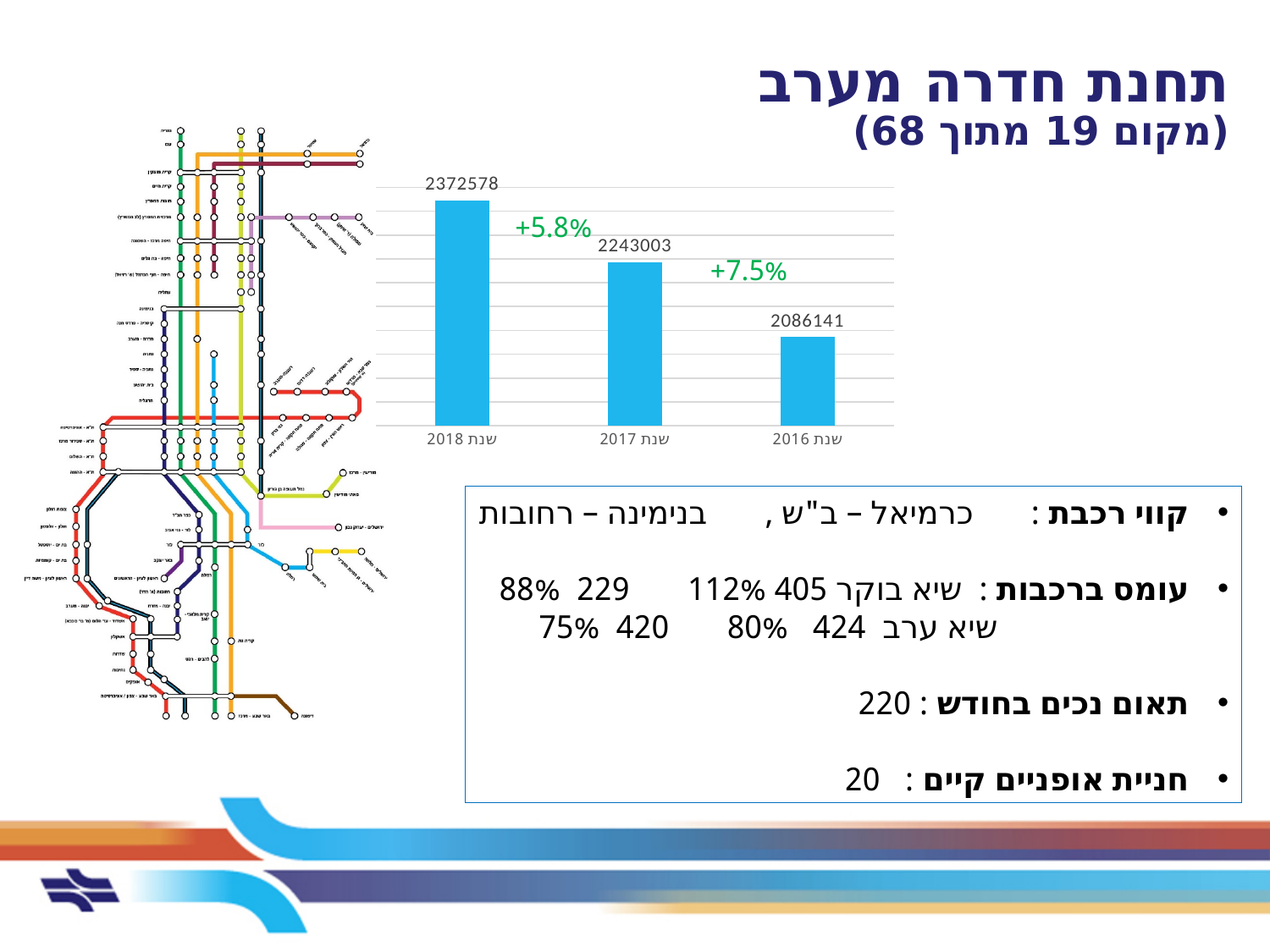
What percentage change is annotated between שנת 2016 and שנת 2017? +7.5% Which is larger, the value for שנת 2017 or the value for שנת 2016? שנת 2017 What value is shown for שנת 2016? 2086141 Which year has the lowest value? שנת 2016 What percentage change is annotated between שנת 2017 and שנת 2018? +5.8% How many bars are in the chart? 3 What value is shown for שנת 2017? 2243003 What kind of chart is shown on the slide? bar chart What is the difference between the values for שנת 2018 and שנת 2017? 129575 What value is shown for שנת 2018? 2372578 What is the difference between the values for שנת 2017 and שנת 2016? 156862 Which year has the highest value? שנת 2018